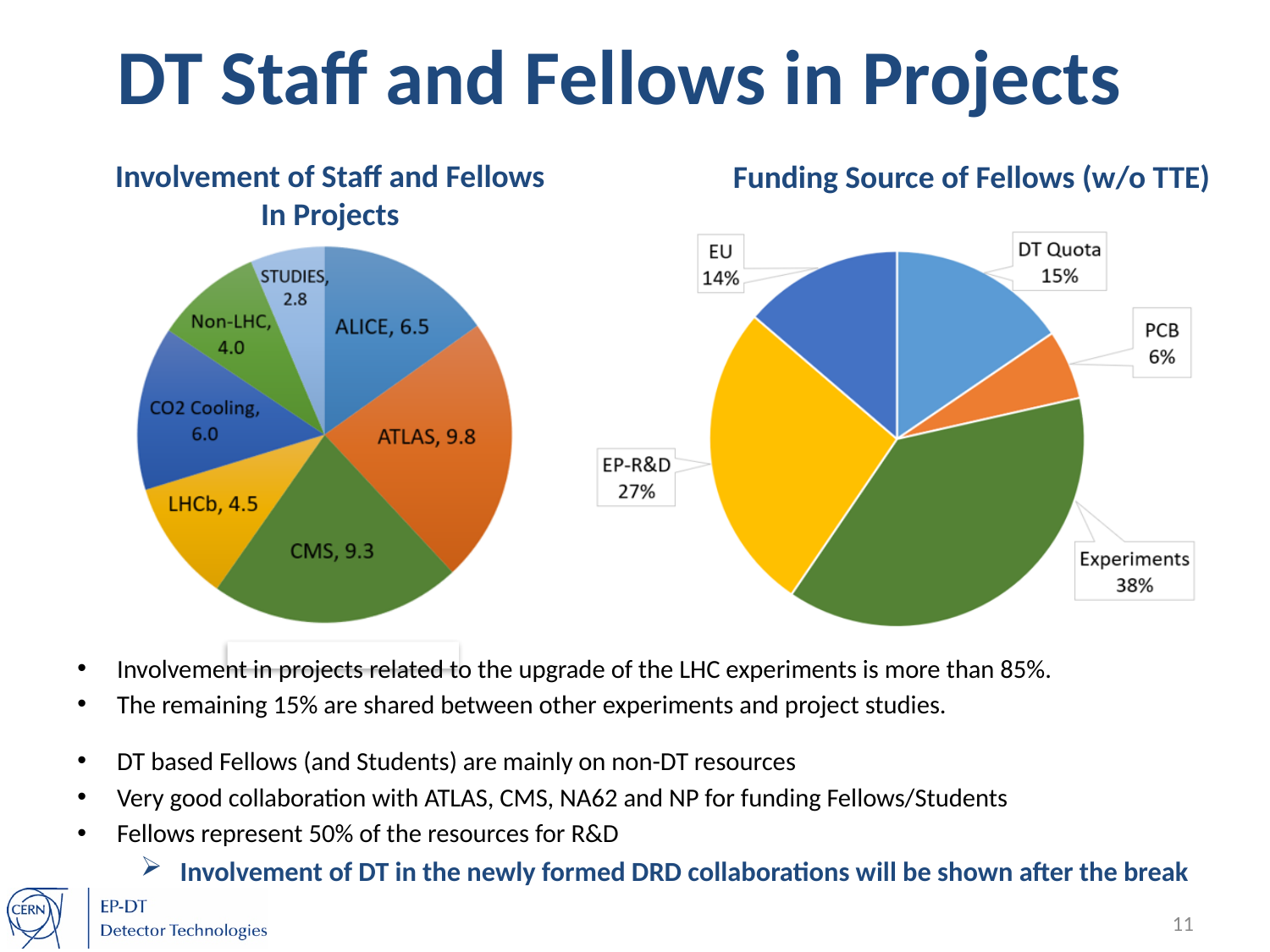
In the 'Involvement of Staff and Fellows In Projects' chart, which category has the highest value? ATLAS In the 'Involvement of Staff and Fellows In Projects' chart, what is the difference between the values for ATLAS and CMS? 0.5 In the 'Funding Source of Fellows (w/o TTE)' chart, what share do Experiments represent? 38% What type of chart is used for 'Funding Source of Fellows (w/o TTE)'? Pie chart In the 'Involvement of Staff and Fellows In Projects' chart, what is the value for ATLAS? 9.8 In the 'Funding Source of Fellows (w/o TTE)' chart, which funding source has the smallest share? PCB In the 'Involvement of Staff and Fellows In Projects' chart, what is the value for CO2 Cooling? 6.0 In the 'Involvement of Staff and Fellows In Projects' chart, which category has the lowest value? STUDIES In the 'Funding Source of Fellows (w/o TTE)' chart, what is the difference between the shares of Experiments and EP-R&D? 11% In the 'Funding Source of Fellows (w/o TTE)' chart, what is the percentage for EP-R&D? 27% In the 'Funding Source of Fellows (w/o TTE)' chart, which is larger, EU or DT Quota? DT Quota In the 'Involvement of Staff and Fellows In Projects' chart, how many categories are shown? 7